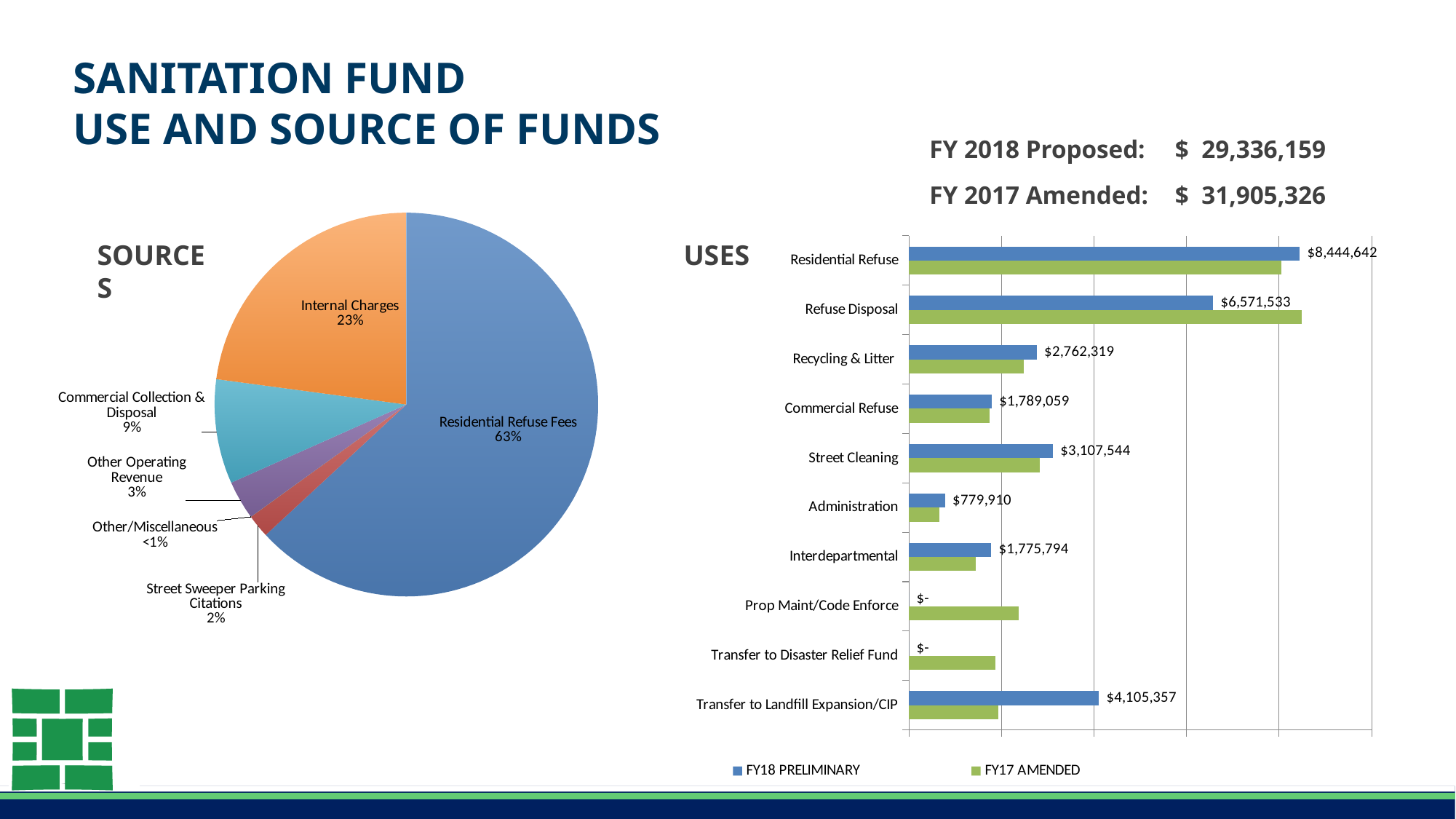
How many categories are shown in the USES bar chart? 10 In the USES bar chart, for Refuse Disposal, which is larger: the FY18 PRELIMINARY bar or the FY17 AMENDED bar? FY17 AMENDED In the USES bar chart, what is the FY18 PRELIMINARY value for Transfer to Landfill Expansion/CIP? $4,105,357 How many slices does the SOURCES pie chart have? 6 In the SOURCES pie chart, which slice is the largest? Residential Refuse Fees In the SOURCES pie chart, what share of the pie is Residential Refuse Fees? 63% In the SOURCES pie chart, what share of the pie is Internal Charges? 23% What kind of chart is the SOURCES chart on the left of the slide? Pie chart In the USES bar chart, what is the difference between the FY18 PRELIMINARY values for Residential Refuse and Refuse Disposal? $1,873,109 What kind of chart is the USES chart on the right of the slide? Bar chart In the USES bar chart, what is the FY18 PRELIMINARY value for Residential Refuse? $8,444,642 In the USES bar chart, how many series does the legend list? 2